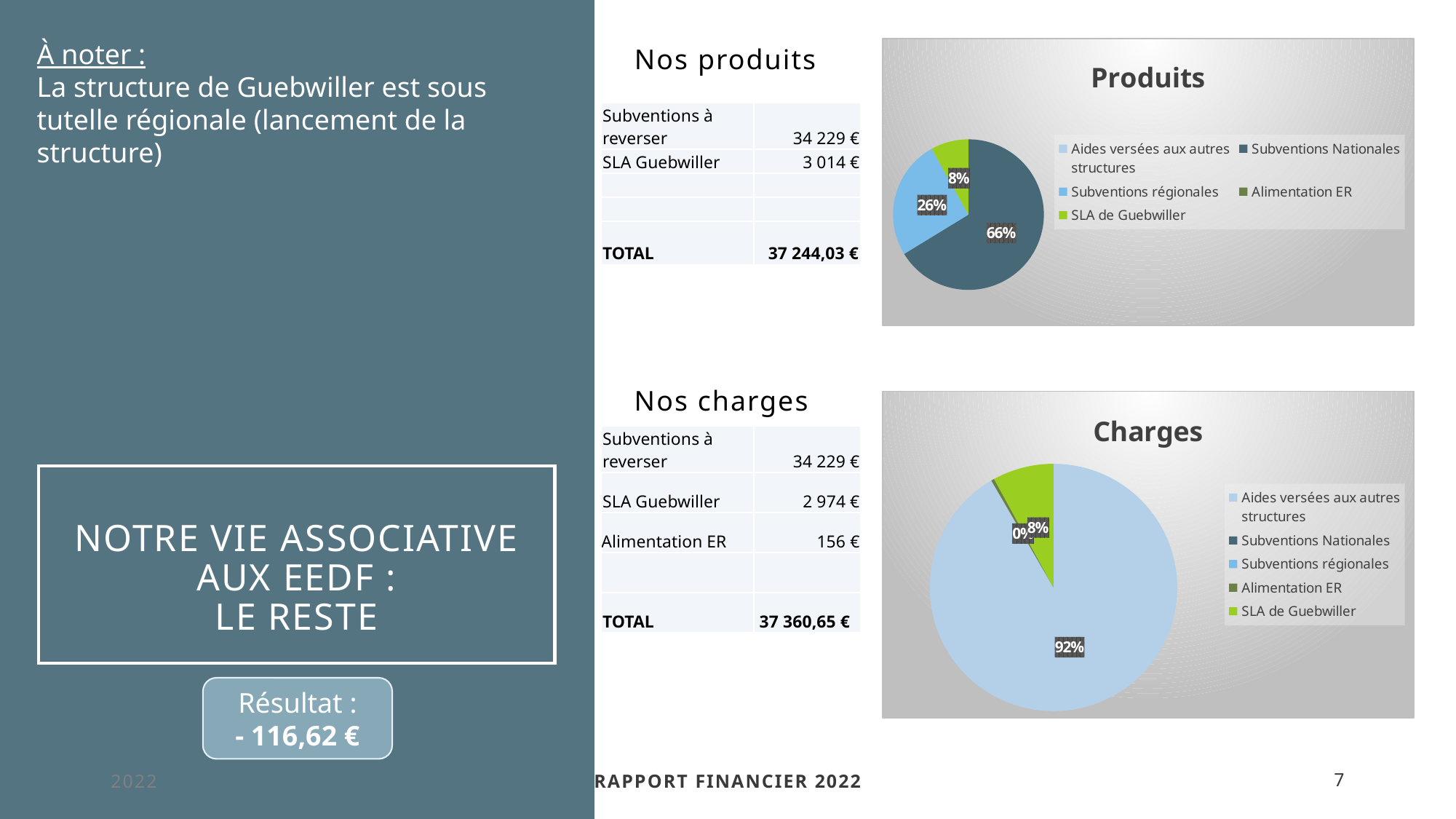
What type of chart is the Produits chart? Pie chart In the Charges chart, which is larger: the SLA de Guebwiller slice or the Alimentation ER slice? SLA de Guebwiller In the Produits chart, which labelled slice is the smallest? SLA de Guebwiller In the Produits chart, which legend entry corresponds to the largest slice? Subventions Nationales In the Charges chart, what percentage is shown for the Alimentation ER slice? 0% In the Produits chart, what is the difference in percentage points between the 66% slice and the 26% slice? 40 How many entries does the legend of the Charges chart list? 5 In the Charges chart, what percentage is shown for the largest slice? 92% In the Produits chart, what percentage is shown for the green slice (SLA de Guebwiller)? 8% In the Charges chart, which legend entry corresponds to the 92% slice? Aides versées aux autres structures